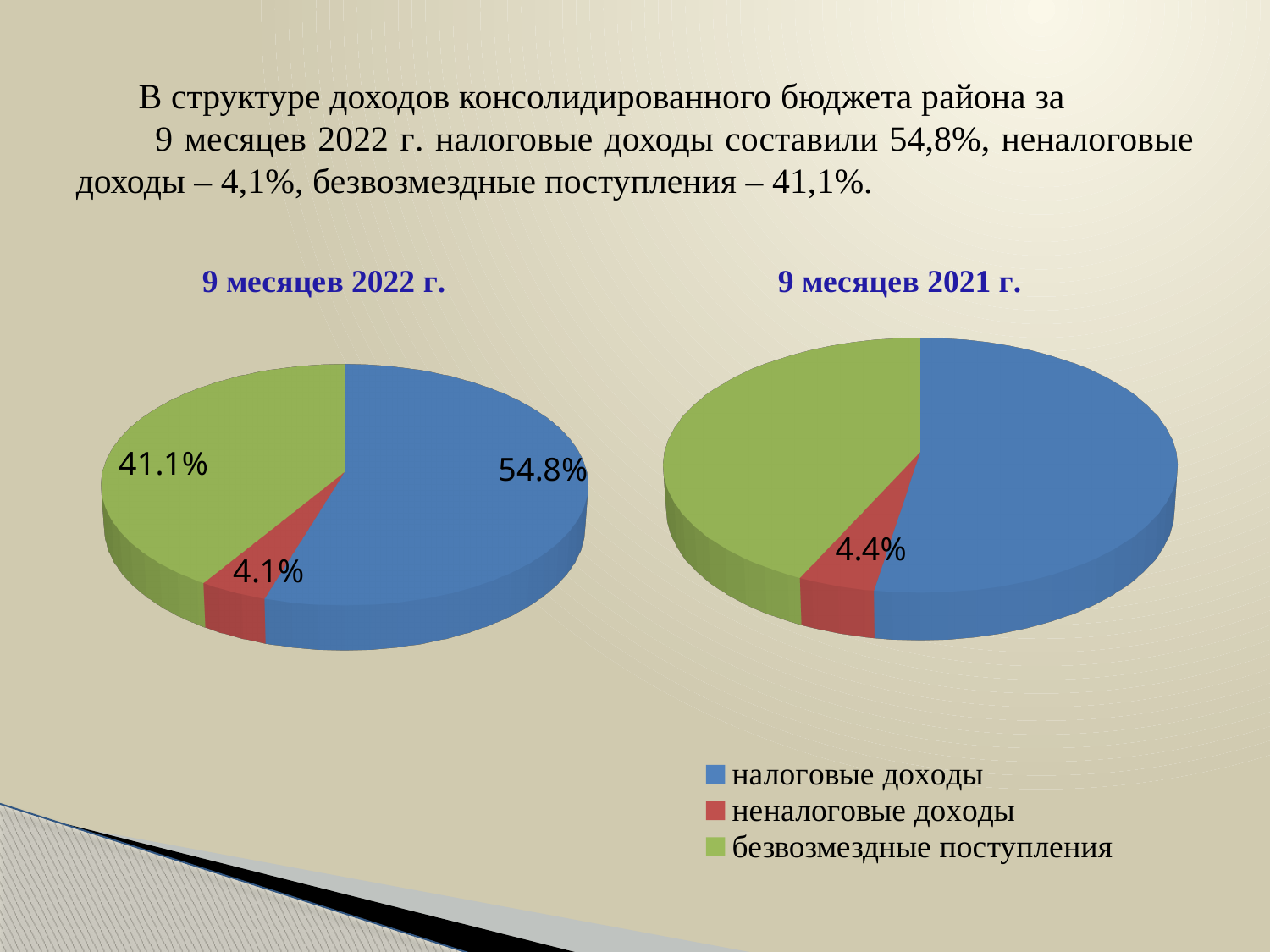
In the '9 месяцев 2021 г.' pie chart, which slice is larger: налоговые доходы or безвозмездные поступления? налоговые доходы Which colour represents безвозмездные поступления in the legend? green In the '9 месяцев 2021 г.' pie chart, what share is shown for неналоговые доходы? 4.4% What type of chart is used for '9 месяцев 2021 г.'? pie chart In the '9 месяцев 2022 г.' pie chart, what share is shown for безвозмездные поступления? 41.1% In the '9 месяцев 2022 г.' pie chart, what share is shown for налоговые доходы? 54.8% In the '9 месяцев 2022 г.' pie chart, which category has the largest slice? налоговые доходы In the '9 месяцев 2022 г.' pie chart, which category has the smallest slice? неналоговые доходы How many slices does the '9 месяцев 2022 г.' pie chart have? 3 In the '9 месяцев 2022 г.' pie chart, what share is shown for неналоговые доходы? 4.1% In the '9 месяцев 2022 г.' pie chart, what is the difference in percentage points between налоговые доходы and безвозмездные поступления? 13.7 In the '9 месяцев 2021 г.' pie chart, which category has the smallest slice? неналоговые доходы